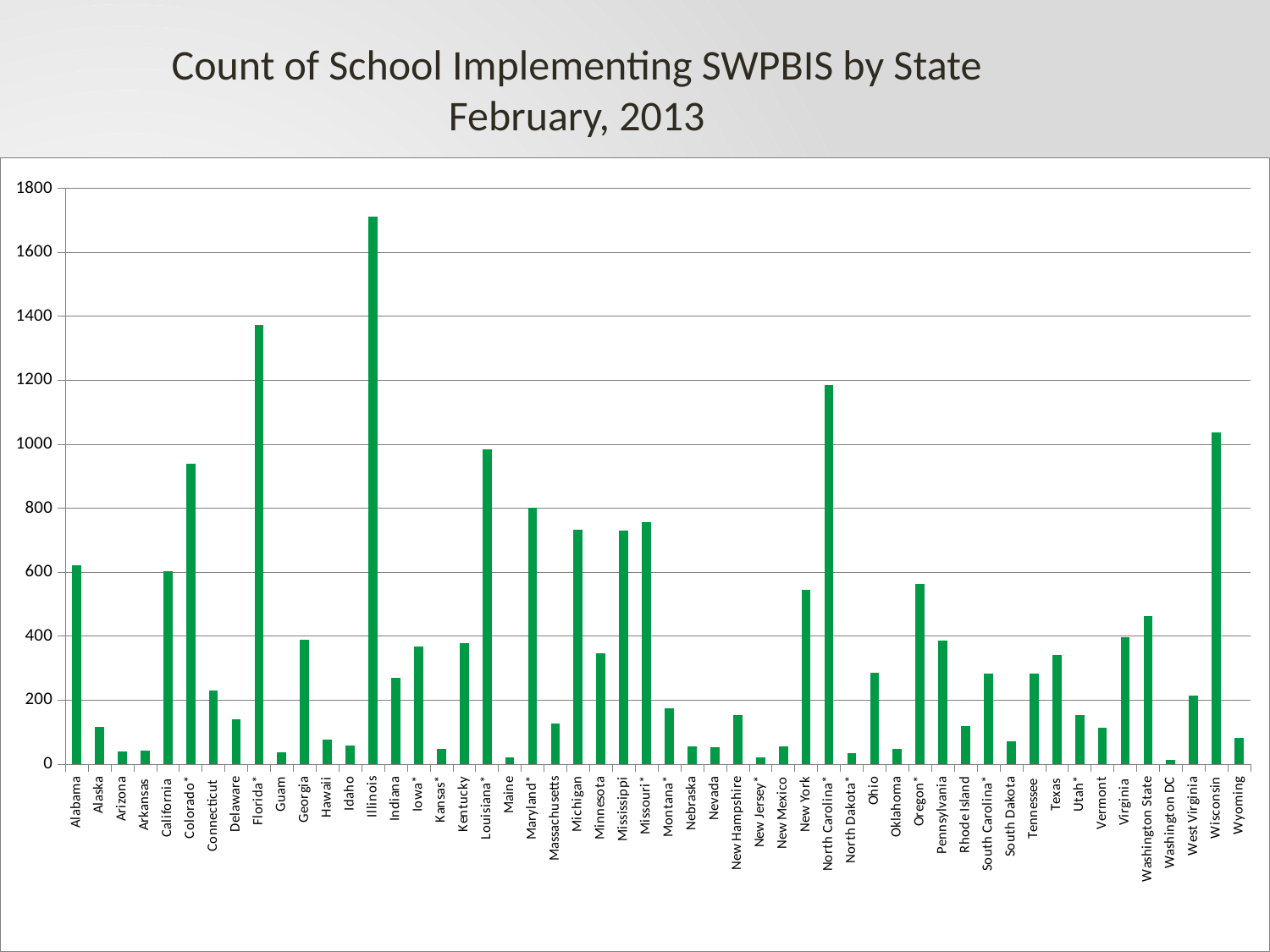
What kind of chart is shown on the slide? bar chart Is the value for North Carolina* greater or less than 1000? greater Is the value for Illinois greater or less than 1600? greater What is the title of the chart? Count of School Implementing SWPBIS by State February, 2013 Which has a higher count, Florida* or North Carolina*? Florida* Is the value for Florida* greater or less than 1200? greater Which state has the highest count of schools implementing SWPBIS? Illinois Which has a higher count, Wisconsin or Washington State? Wisconsin Which has a higher count, Michigan or Minnesota? Michigan Which category has the lowest count of schools implementing SWPBIS? Washington DC How many categories (states/territories) are shown on the x axis? 52